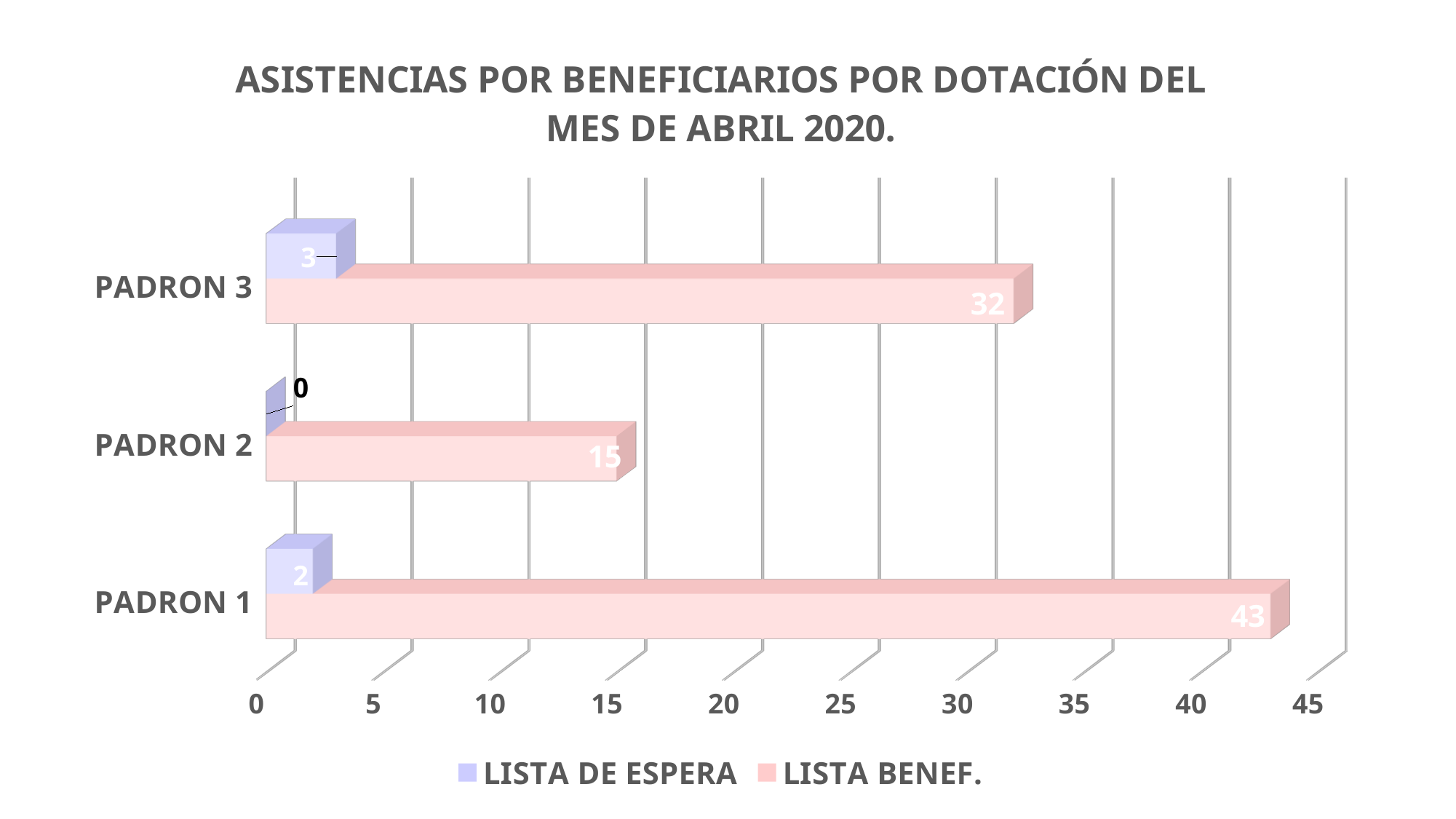
How many categories are shown on the chart? 3 What is the difference between the LISTA BENEF. values for PADRON 1 and PADRON 3? 11 Is the LISTA BENEF. value for PADRON 1 greater or less than 40? greater Which category has the highest LISTA BENEF. value? PADRON 1 What kind of chart is shown on the slide? bar chart What is the LISTA BENEF. value for PADRON 1? 43 How many series does the legend list? 2 What is the LISTA BENEF. value for PADRON 2? 15 Which is larger, the LISTA BENEF. value for PADRON 2 or for PADRON 3? PADRON 3 Which category has the lowest LISTA DE ESPERA value? PADRON 2 What is the LISTA DE ESPERA value for PADRON 2? 0 What is the LISTA DE ESPERA value for PADRON 3? 3